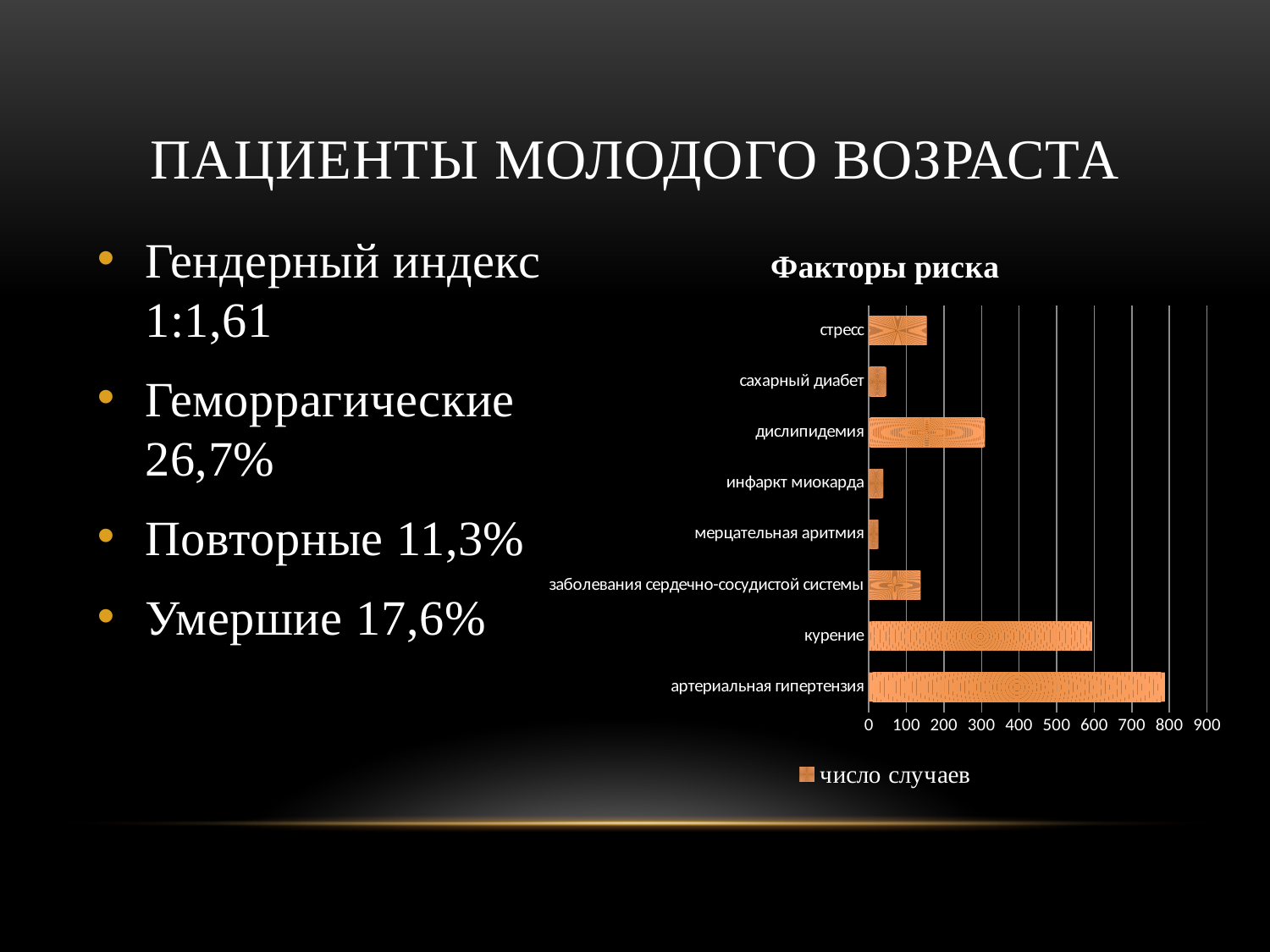
What is the title of the chart? Факторы риска Is the value for сахарный диабет greater or less than 100? less Which risk factor has the lowest number of cases? мерцательная аритмия Is the value for артериальная гипертензия greater or less than 700? greater What type of chart is shown on the slide? bar chart Which has more cases, курение or дислипидемия? курение How many series does the chart legend list? 1 How many categories are shown in the chart? 8 What is the name of the series in the chart legend? число случаев Which has more cases, стресс or инфаркт миокарда? стресс Is the value for курение greater or less than 500? greater Which risk factor has the highest number of cases? артериальная гипертензия